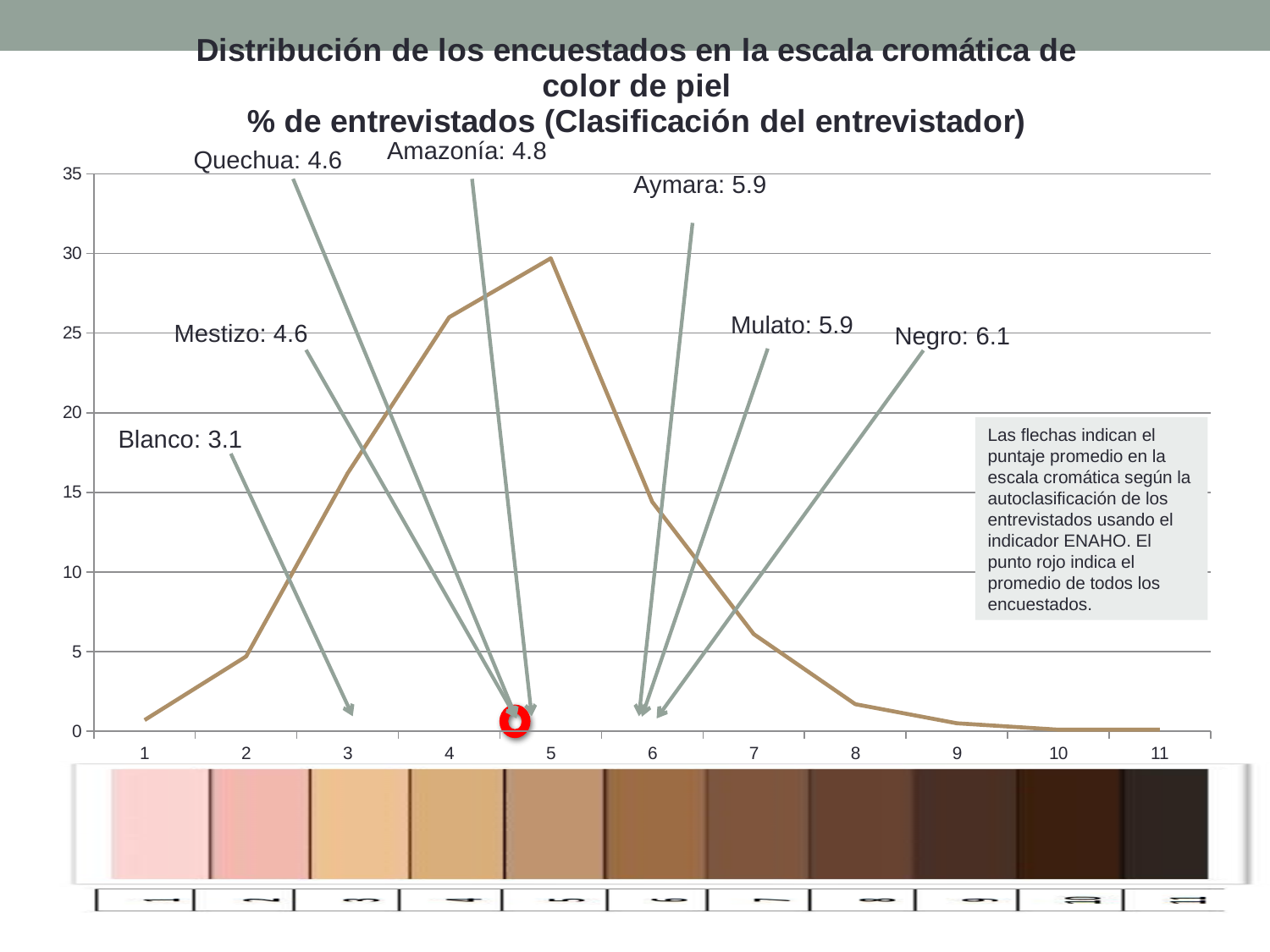
What average score on the chromatic scale is indicated for Amazonía? 4.8 Which group has the higher indicated average score, Aymara or Mestizo? Aymara Is the value at scale point 5 greater or less than 25? greater Do the values rise or fall along the x axis from scale point 5 to scale point 11? fall How many points on the skin colour scale are plotted along the x axis? 11 At which scale value does the line reach its highest percentage? 5 What average score on the chromatic scale is indicated for Blanco? 3.1 What is the difference between the average scores indicated for Negro and Blanco? 3.0 Is the value at scale point 3 greater or less than 15? greater What kind of chart is shown on the slide? line chart Is the value at scale point 8 greater or less than 5? less What average score on the chromatic scale is indicated for Negro? 6.1